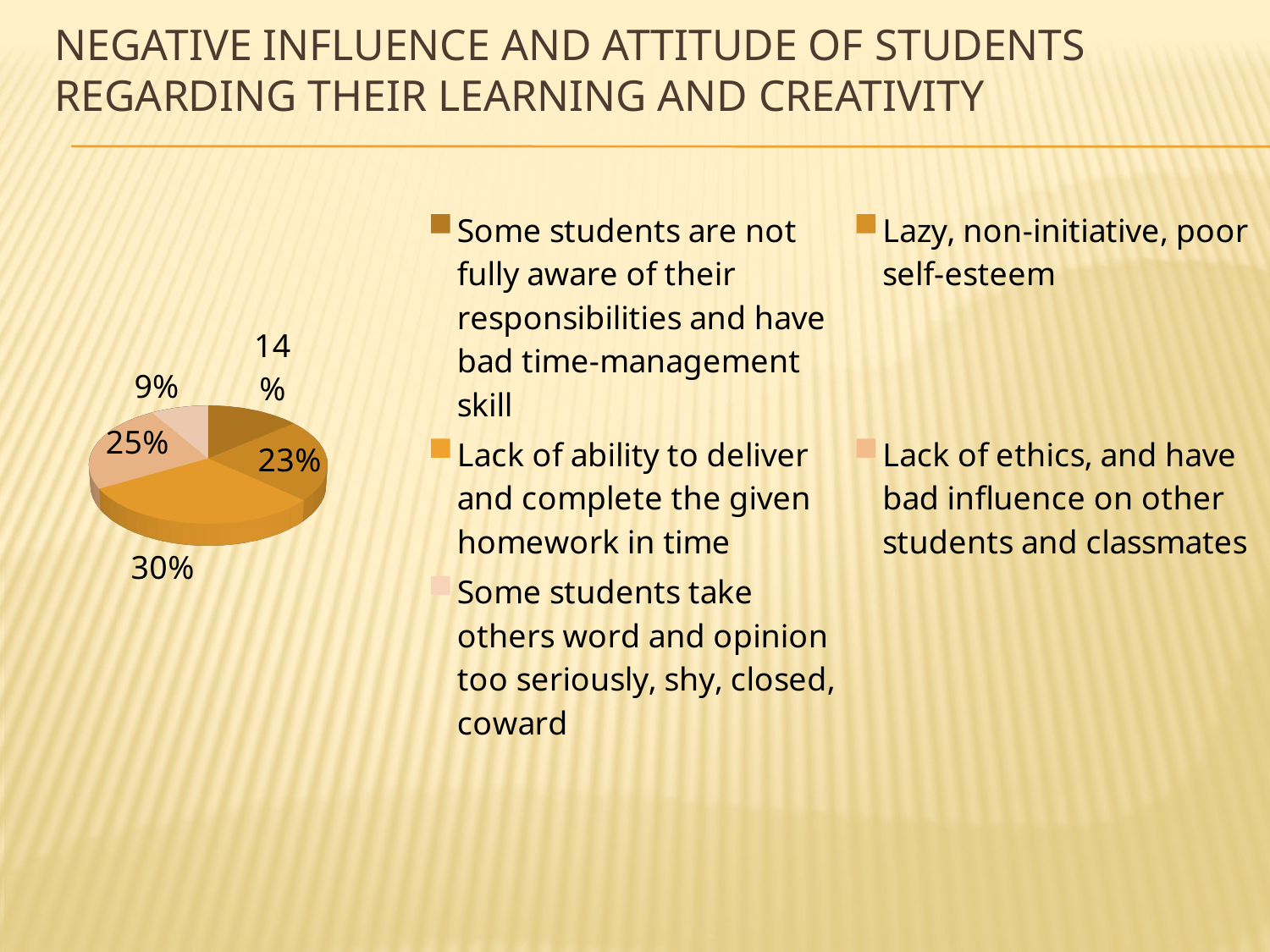
What kind of chart is shown on the slide? pie chart What is the percentage of the smallest slice in the pie chart? 9% What is the difference in percentage points between the largest slice (30%) and the smallest slice (9%)? 21 What is the difference in percentage points between the 25% slice and the 14% slice? 11 Which is larger, the 25% slice or the 23% slice? 25% What is the difference in percentage points between the 30% slice and the 23% slice? 7 What is the percentage of the largest slice in the pie chart? 30% How many slices does the pie chart have? 5 Which is larger, the 14% slice or the 9% slice? 14% What is the second-largest percentage shown in the pie chart? 25% Is the pie chart drawn in 3D? yes How many legend entries (bulleted items) accompany the pie chart? 5